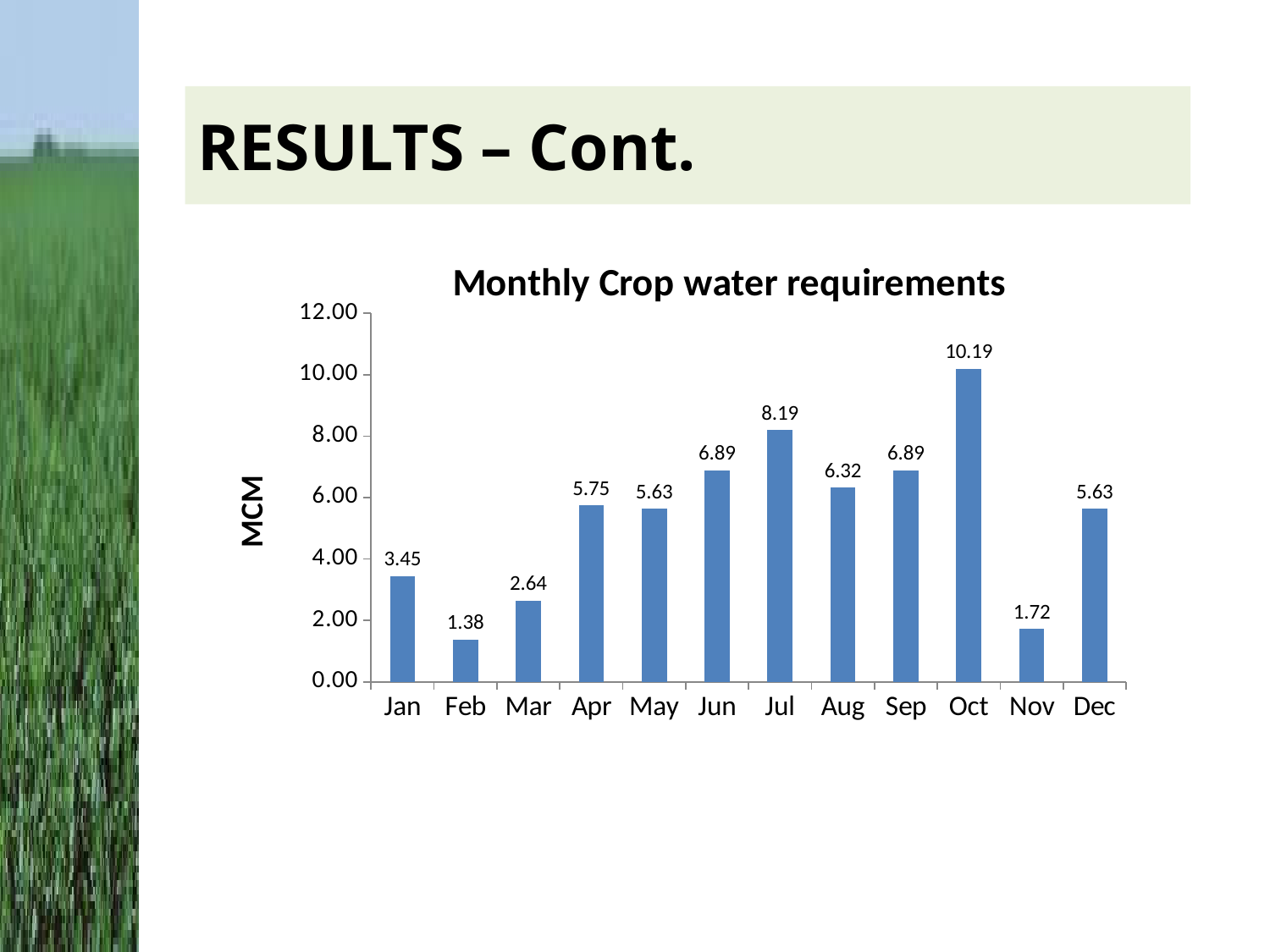
What is the label on the vertical axis of the chart? MCM Which month has the lowest crop water requirement? Feb Which month has the highest crop water requirement? Oct Which is larger, the value for Apr or the value for Aug? Aug What is the value shown for Jul? 8.19 What is the monthly crop water requirement for Oct? 10.19 Is the value for Sep greater or less than 6.00? greater What type of chart is shown on the slide? bar chart What is the difference between the values for Oct and Nov? 8.47 What is the value shown for Feb? 1.38 How many months are shown on the x axis? 12 What is the difference between the values for Jul and Jan? 4.74